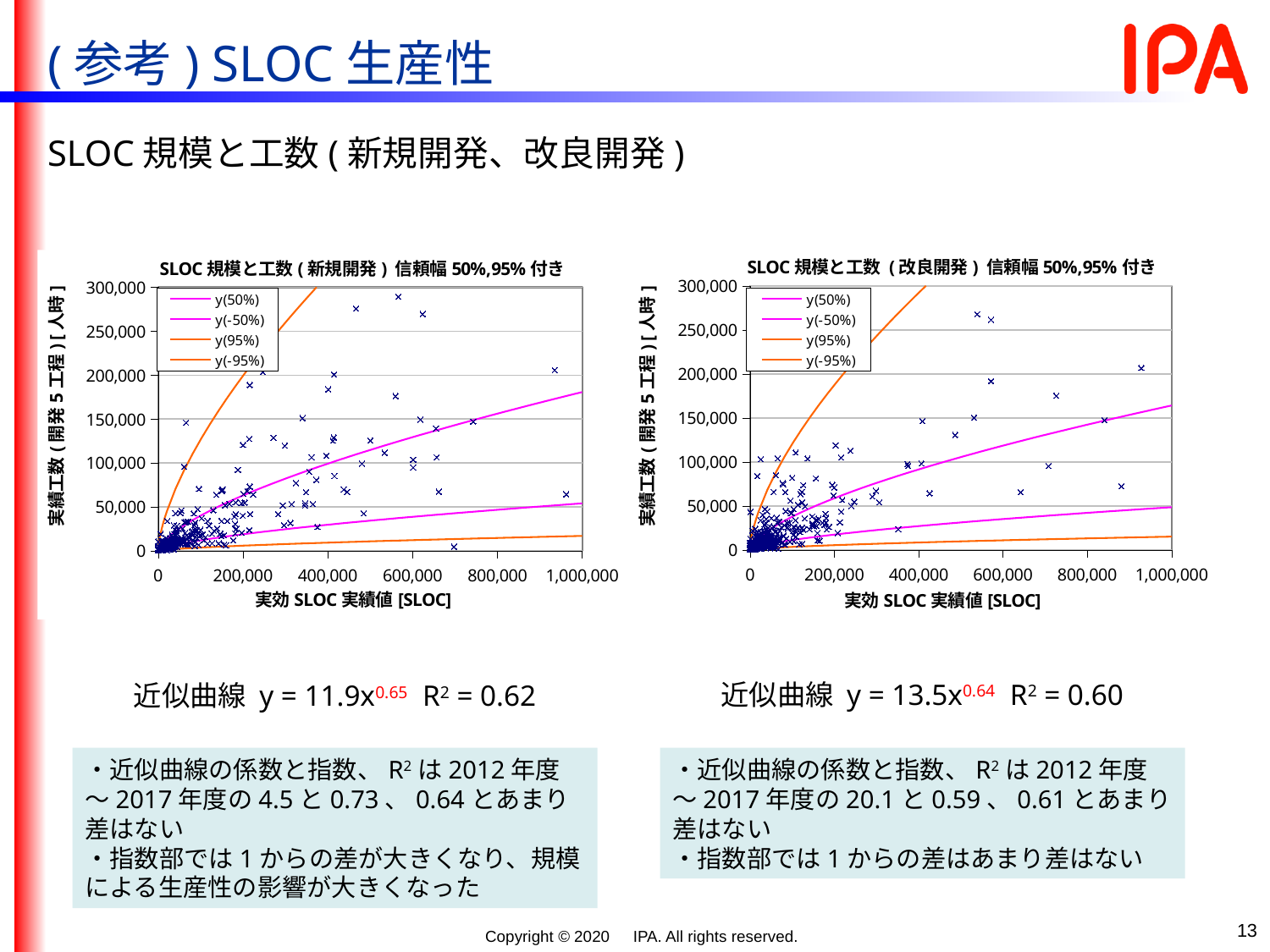
In the left chart (新規開発), is the value of the y(-95%) line at 1,000,000 SLOC greater or less than 50,000? less What kind of chart is the right chart titled 'SLOC規模と工数(改良開発) 信頼幅50%,95%付き'? scatter chart In the right chart (改良開発), is the value of the y(-50%) line at 1,000,000 SLOC greater or less than 100,000? less In the right chart (改良開発), how many series does the legend list? 4 In the right chart (改良開発), does the y(50%) line rise or fall as the x axis increases? rise In the left chart (新規開発), how many series does the legend list? 4 In the left chart (新規開発), is the value of the y(50%) line at 1,000,000 SLOC greater or less than 150,000? greater What is the x-axis label of the left chart (新規開発)? 実効SLOC実績値[SLOC] What kind of chart is the left chart titled 'SLOC規模と工数(新規開発) 信頼幅50%,95%付き'? scatter chart What is the highest tick value shown on the y axis of the right chart (改良開発)? 300,000 In the left chart (新規開発), which line is higher at 1,000,000 SLOC, y(50%) or y(-50%)? y(50%)